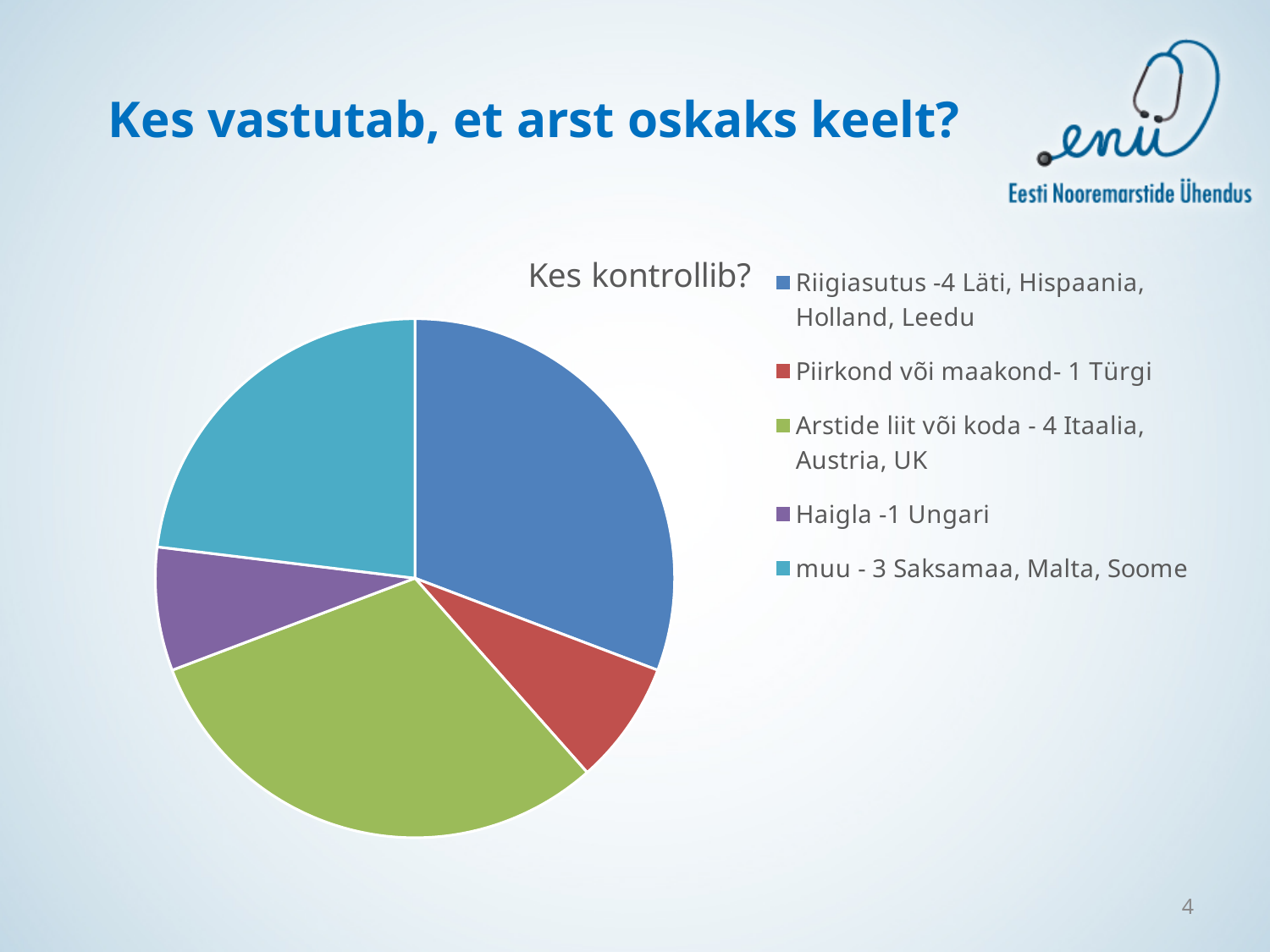
What is the title of the pie chart? Kes kontrollib? What is the difference between the number of countries under "muu" and under "Haigla"? 2 According to the legend, how many countries fall under "muu"? 3 How many entries does the legend of the pie chart list? 5 How many slices does the pie chart have? 5 According to the legend, how many countries fall under "Haigla"? 1 According to the legend, how many countries fall under "Arstide liit või koda"? 4 According to the legend, how many countries fall under "Piirkond või maakond"? 1 Which slice is larger: "Riigiasutus" or "Piirkond või maakond"? Riigiasutus According to the legend, how many countries fall under "Riigiasutus"? 4 What kind of chart is shown on the slide? pie chart Which colour represents "Haigla" in the pie chart? purple